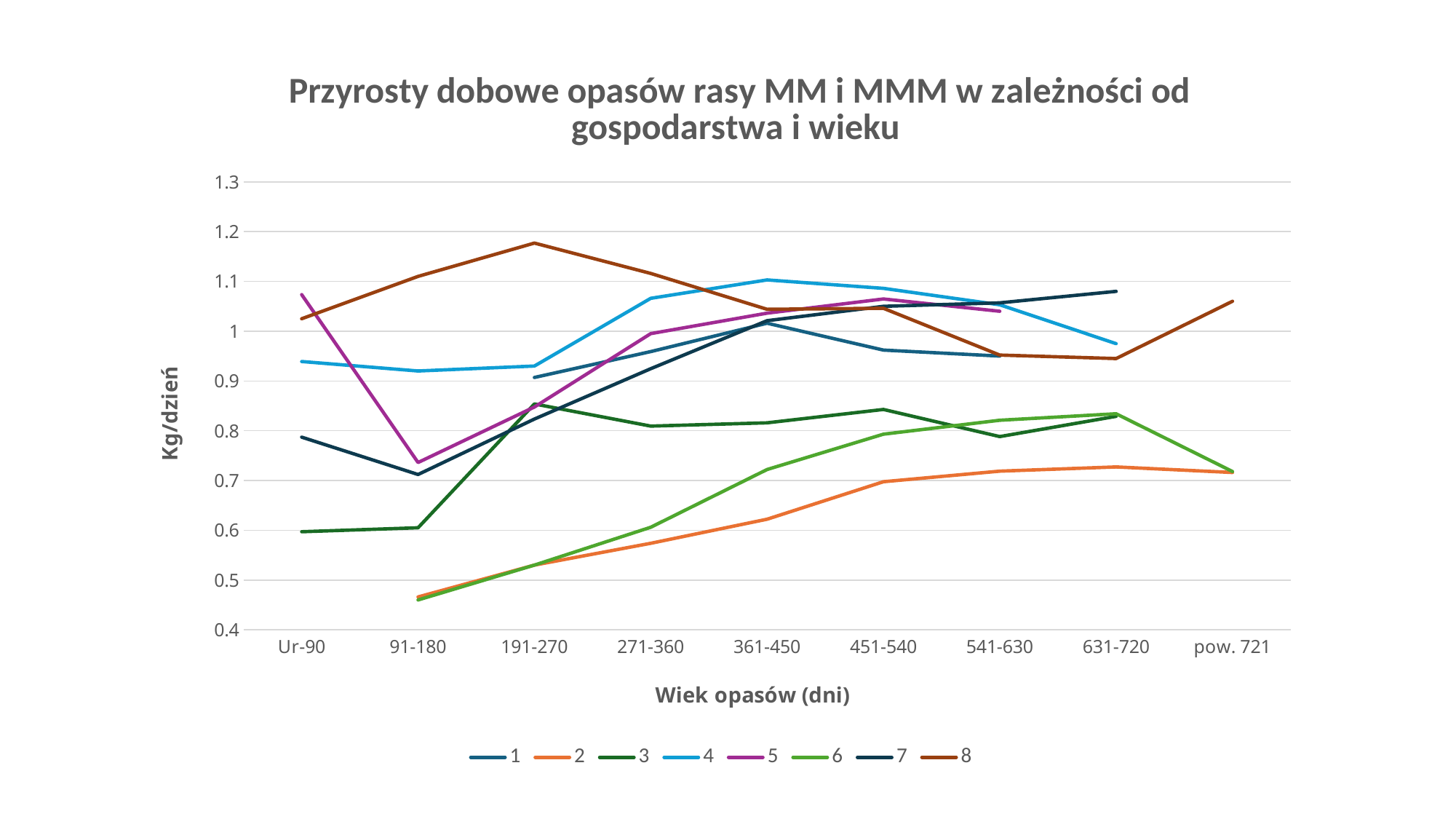
How many series does the legend list? 8 Which series has the lowest value at Ur-90? 3 How many age categories are shown on the x axis? 9 Which series has the highest value at 191-270? 8 Is the value for series 2 at 91-180 greater or less than 0.5? less At 361-450, which series has the larger value, series 4 or series 6? 4 Is the value for series 3 at Ur-90 greater or less than 0.7? less What is the label of the y axis? Kg/dzień Is the value for series 7 at 631-720 greater or less than 1? greater Does series 2 rise or fall from 91-180 to 631-720? rise What kind of chart is shown on the slide? line chart